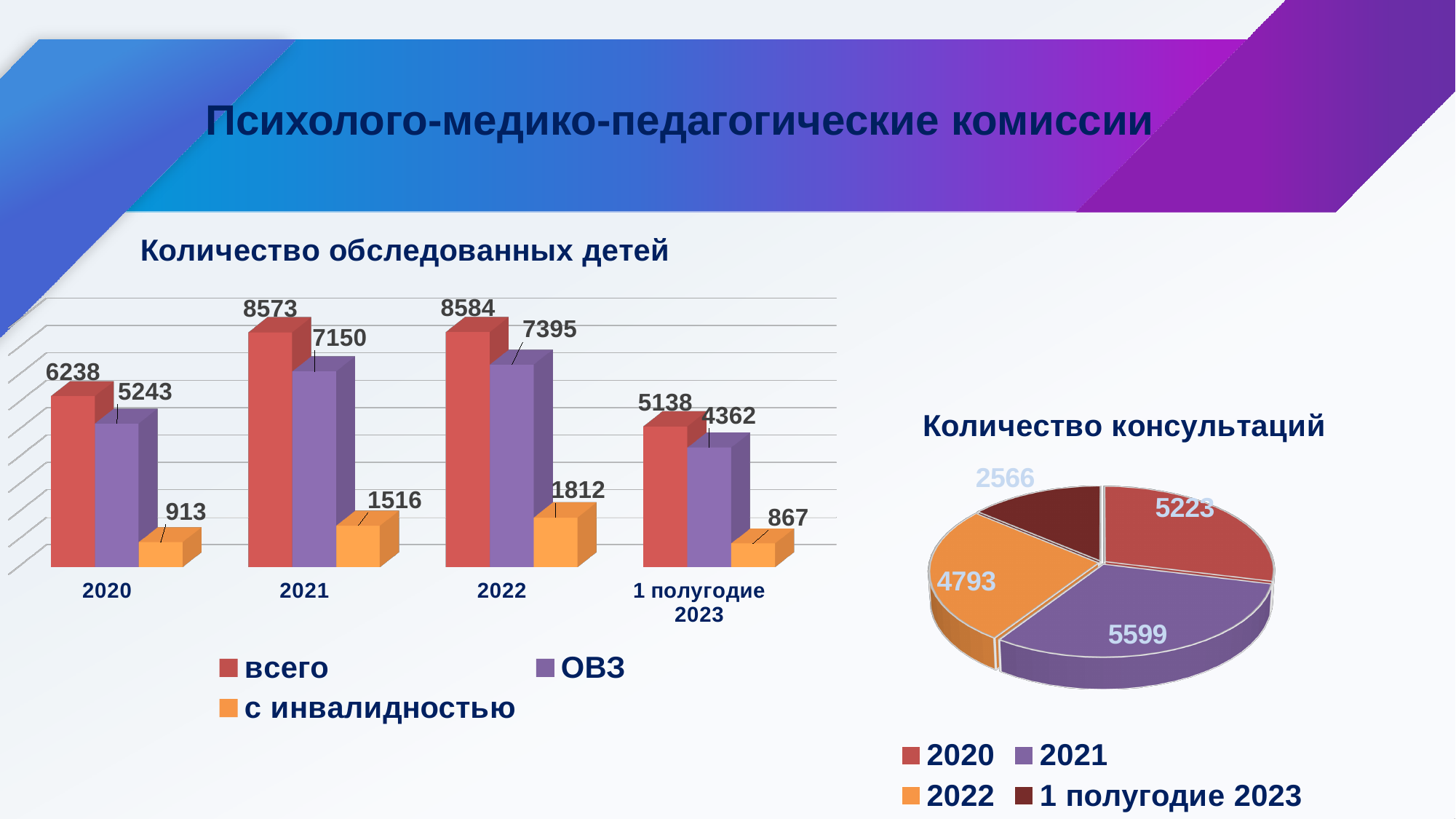
In the chart 'Количество обследованных детей', which category has the lowest 'с инвалидностью' value? 1 полугодие 2023 In the chart 'Количество обследованных детей', which category has the highest 'всего' value? 2022 In the chart 'Количество обследованных детей', how many categories are shown on the x axis? 4 In the chart 'Количество консультаций', is the value for 2020 or 2021 larger? 2021 In the chart 'Количество консультаций', what is the value for 2022? 4793 In the chart 'Количество обследованных детей', what is the value of 'всего' for 2021? 8573 In the chart 'Количество обследованных детей', what is the difference between 'всего' and 'ОВЗ' for 2020? 995 What kind of chart is 'Количество консультаций'? Pie chart In the chart 'Количество консультаций', which year has the largest slice? 2021 In the chart 'Количество обследованных детей', what is the value of 'ОВЗ' for 1 полугодие 2023? 4362 In the chart 'Количество обследованных детей', how many series does the legend list? 3 In the chart 'Количество обследованных детей', what is the value of 'с инвалидностью' for 2022? 1812